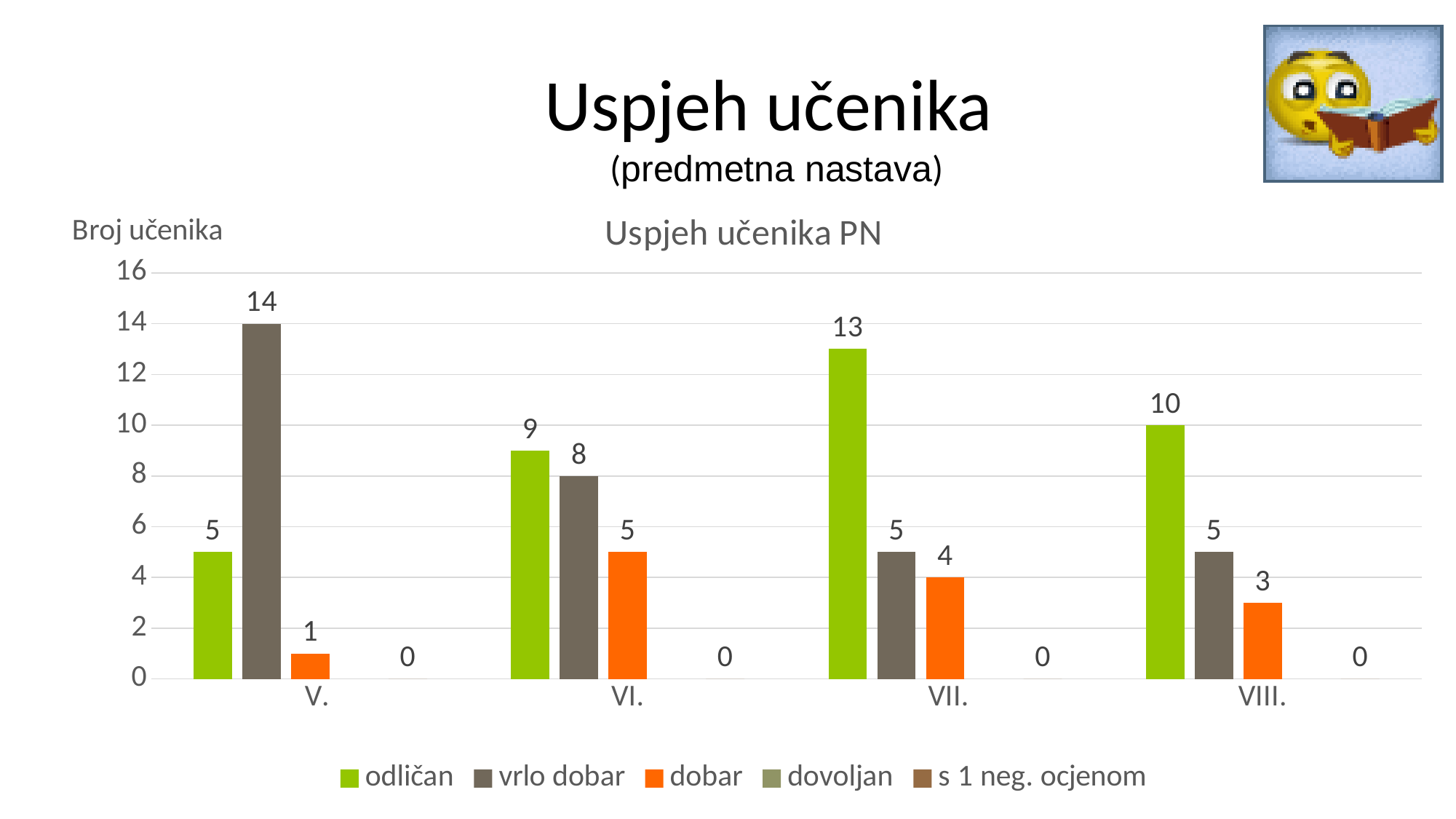
What is the title of the chart? Uspjeh učenika PN What is the difference between vrlo dobar and odličan in class V.? 9 What kind of chart is shown? bar chart How many series does the legend list? 5 Which is larger in class VI., odličan or vrlo dobar? odličan What is the value for odličan in class VII.? 13 Which class has the highest value for odličan? VII. What is the value for vrlo dobar in class V.? 14 What colour are the bars for dobar? orange What is the value for dobar in class VIII.? 3 Which class has the lowest value for dobar? V. How many classes are shown on the x axis? 4